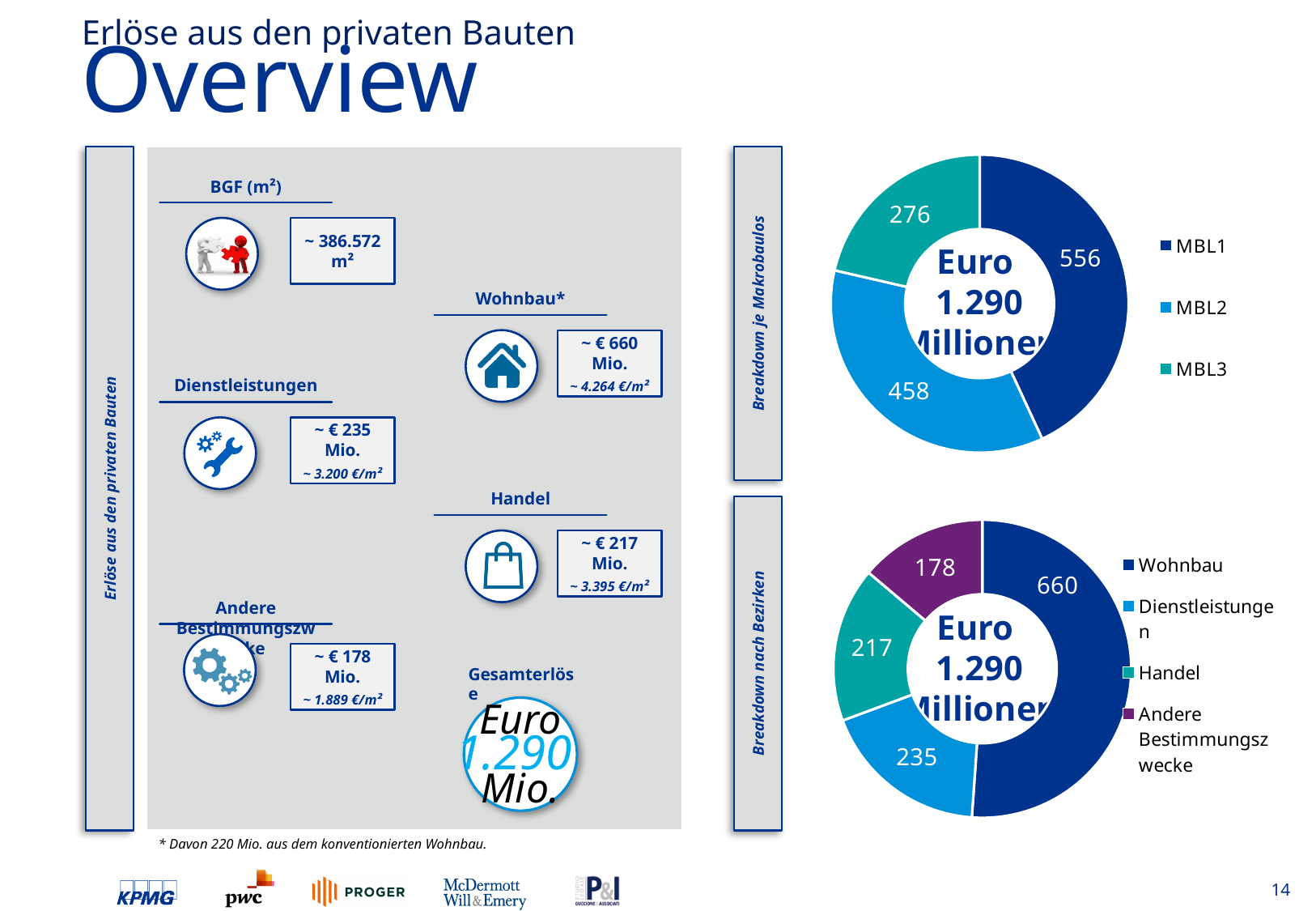
In the top doughnut chart (Breakdown je Makrobaulos), what is the value for MBL1? 556 In the top doughnut chart (Breakdown je Makrobaulos), which category has the largest value? MBL1 In the bottom doughnut chart (Breakdown nach Bezirken), what is the value for Handel? 217 In the bottom doughnut chart (Breakdown nach Bezirken), which category has the smallest value? Andere Bestimmungszwecke How many categories does the legend of the top doughnut chart (Breakdown je Makrobaulos) list? 3 In the top doughnut chart (Breakdown je Makrobaulos), what is the value for MBL3? 276 In the bottom doughnut chart (Breakdown nach Bezirken), which is larger: Wohnbau or Dienstleistungen? Wohnbau In the top doughnut chart (Breakdown je Makrobaulos), what is the difference between MBL1 and MBL2? 98 In the bottom doughnut chart (Breakdown nach Bezirken), what is the value for Dienstleistungen? 235 What type of chart is used for the Breakdown nach Bezirken? Doughnut chart In the bottom doughnut chart (Breakdown nach Bezirken), what is the difference between Wohnbau and Andere Bestimmungszwecke? 482 What total is shown in the centre of the top doughnut chart (Breakdown je Makrobaulos)? Euro 1.290 Millionen